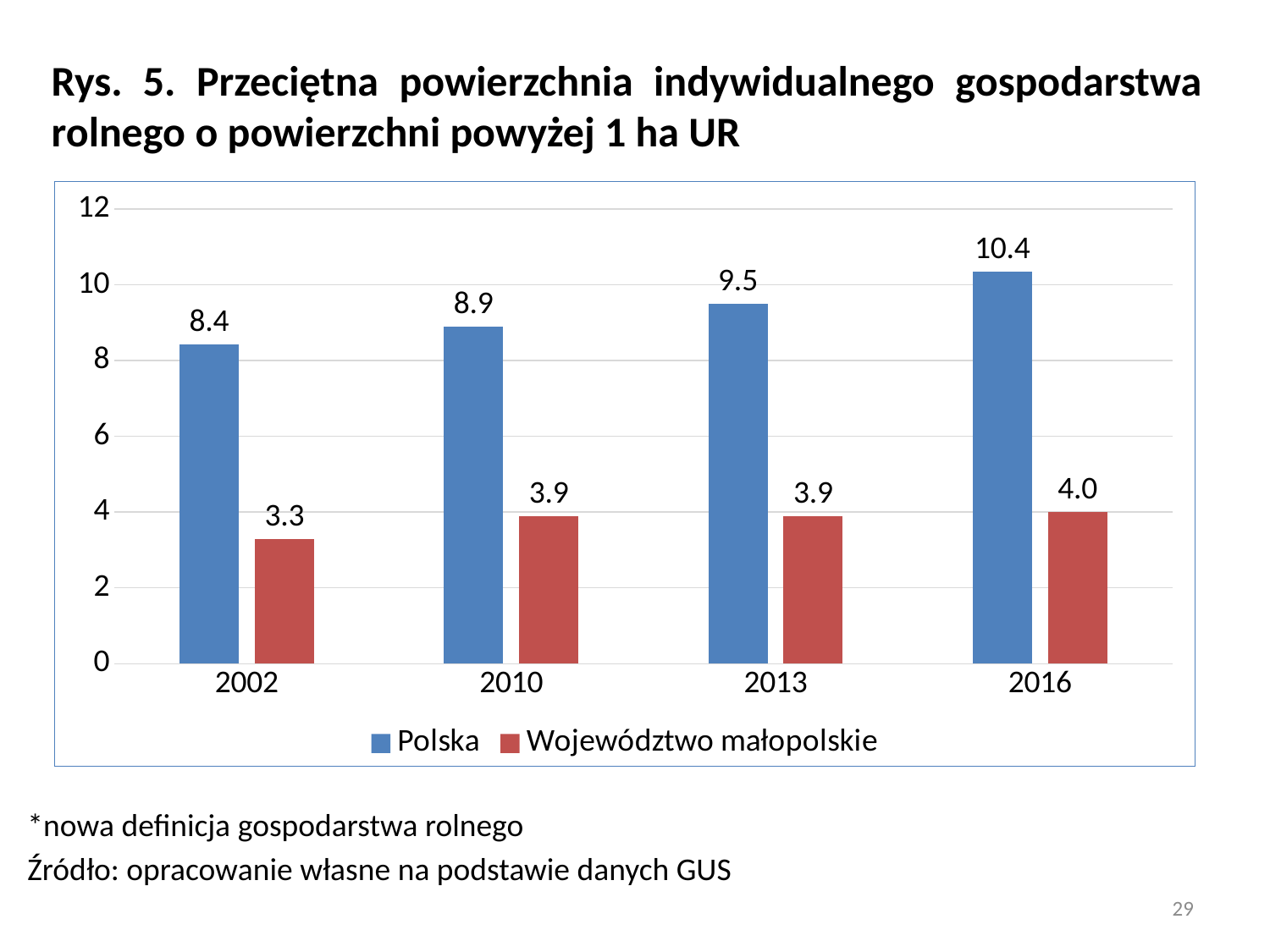
What is the difference between the Polska and Województwo małopolskie values in 2010? 5.0 What is the value for Województwo małopolskie in 2013? 3.9 Which is larger in 2013: the value for Polska or for Województwo małopolskie? Polska What is the value for Polska in 2016? 10.4 In which year is the value for Województwo małopolskie lowest? 2002 How many years are shown on the x axis? 4 What kind of chart is shown? bar chart Do the values for Polska rise or fall from 2002 to 2016? rise In which year is the value for Polska highest? 2016 How many series does the legend list? 2 What is the value for Województwo małopolskie in 2002? 3.3 Is the value for Polska in 2002 greater or less than 8? greater